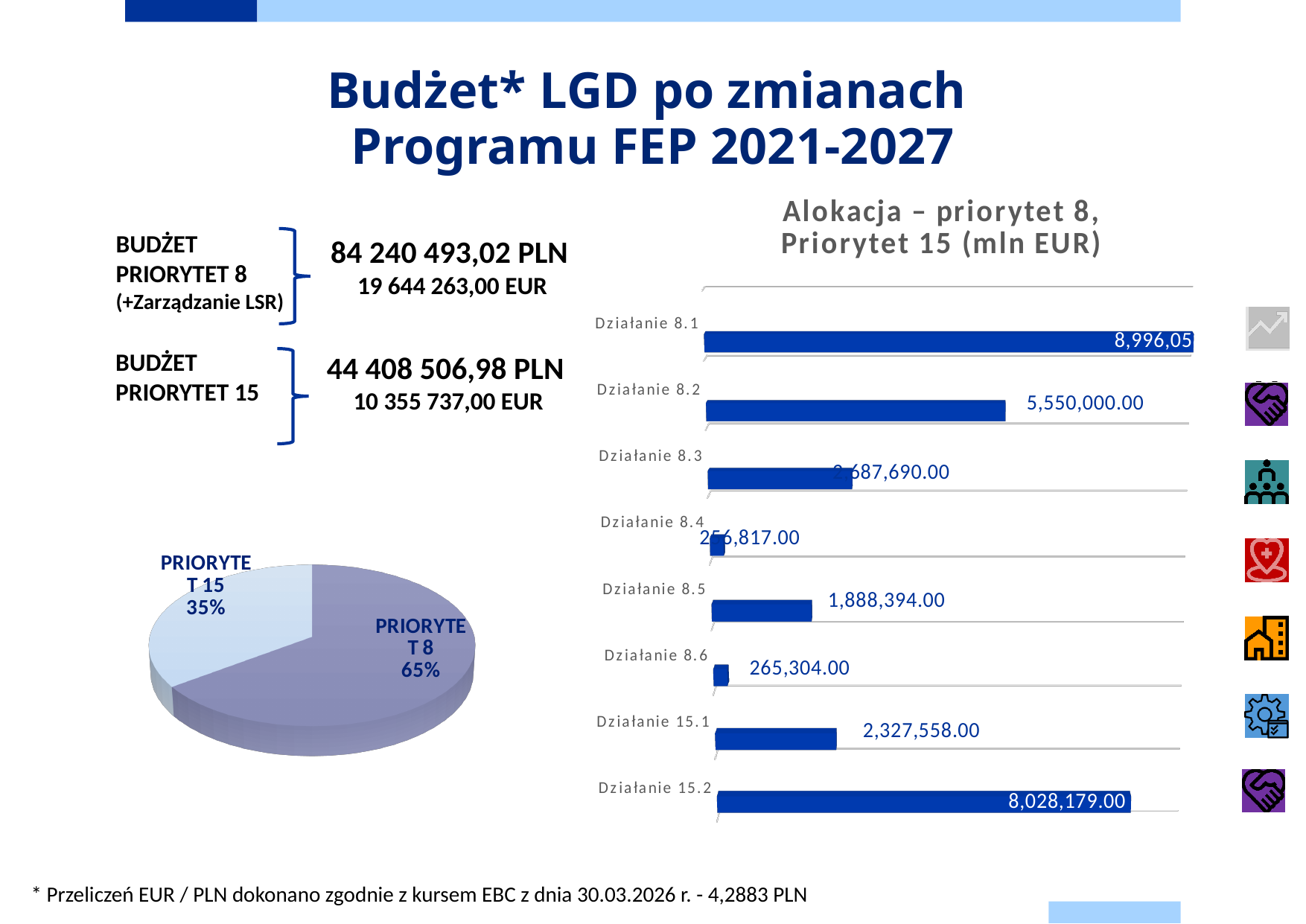
In the chart 'Alokacja – priorytet 8, Priorytet 15 (mln EUR)', what is the difference between the values for Działanie 15.1 and Działanie 8.5? 439,164.00 In the chart 'Alokacja – priorytet 8, Priorytet 15 (mln EUR)', what is the value for Działanie 8.5? 1,888,394.00 What kind of chart is the chart on the left of the slide? Pie chart In the chart 'Alokacja – priorytet 8, Priorytet 15 (mln EUR)', what is the value for Działanie 8.2? 5,550,000.00 In the pie chart, which slice is larger, PRIORYTET 8 or PRIORYTET 15? PRIORYTET 8 In the pie chart, what share does PRIORYTET 15 have? 35% In the chart 'Alokacja – priorytet 8, Priorytet 15 (mln EUR)', which category has the highest value? Działanie 8.1 In the chart 'Alokacja – priorytet 8, Priorytet 15 (mln EUR)', what is the value for Działanie 15.2? 8,028,179.00 In the chart 'Alokacja – priorytet 8, Priorytet 15 (mln EUR)', what is the value for Działanie 8.6? 265,304.00 What kind of chart is the chart titled 'Alokacja – priorytet 8, Priorytet 15 (mln EUR)'? Bar chart In the chart 'Alokacja – priorytet 8, Priorytet 15 (mln EUR)', how many categories (Działanie) are shown? 8 In the pie chart, what share does PRIORYTET 8 have? 65%